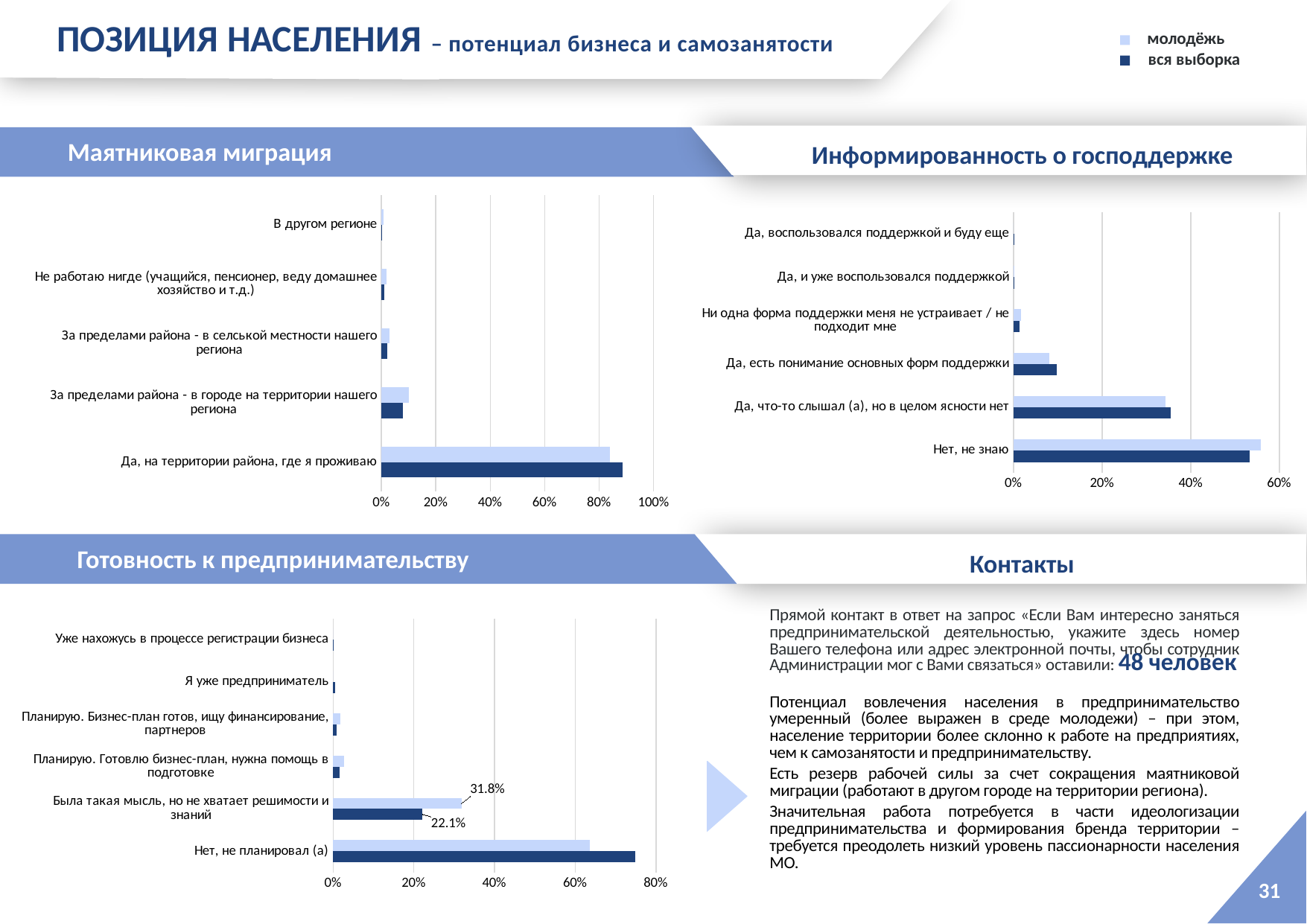
In the 'Маятниковая миграция' chart, how many categories are shown? 5 What kind of chart is used in the 'Маятниковая миграция' section? Bar chart In the 'Готовность к предпринимательству' chart, what is the value for 'молодёжь' in the category 'Была такая мысль, но не хватает решимости и знаний'? 31.8% In the 'Информированность о господдержке' chart, is the 'молодёжь' value for 'Нет, не знаю' greater or less than 40%? greater In the 'Информированность о господдержке' chart, how many categories are shown? 6 In the 'Маятниковая миграция' chart, is the 'вся выборка' value for 'Да, на территории района, где я проживаю' greater or less than 80%? greater In the 'Готовность к предпринимательству' chart, what is the difference between the 'молодёжь' and 'вся выборка' values for 'Была такая мысль, но не хватает решимости и знаний'? 9.7 percentage points In the 'Готовность к предпринимательству' chart, for 'Нет, не планировал (а)', which series has the larger value: 'молодёжь' or 'вся выборка'? вся выборка How many series does the legend at the top right of the slide list? 2 In the 'Информированность о господдержке' chart, which category has the highest values? Нет, не знаю In the 'Готовность к предпринимательству' chart, what is the value for 'вся выборка' in the category 'Была такая мысль, но не хватает решимости и знаний'? 22.1% In the 'Маятниковая миграция' chart, which category has the highest values? Да, на территории района, где я проживаю